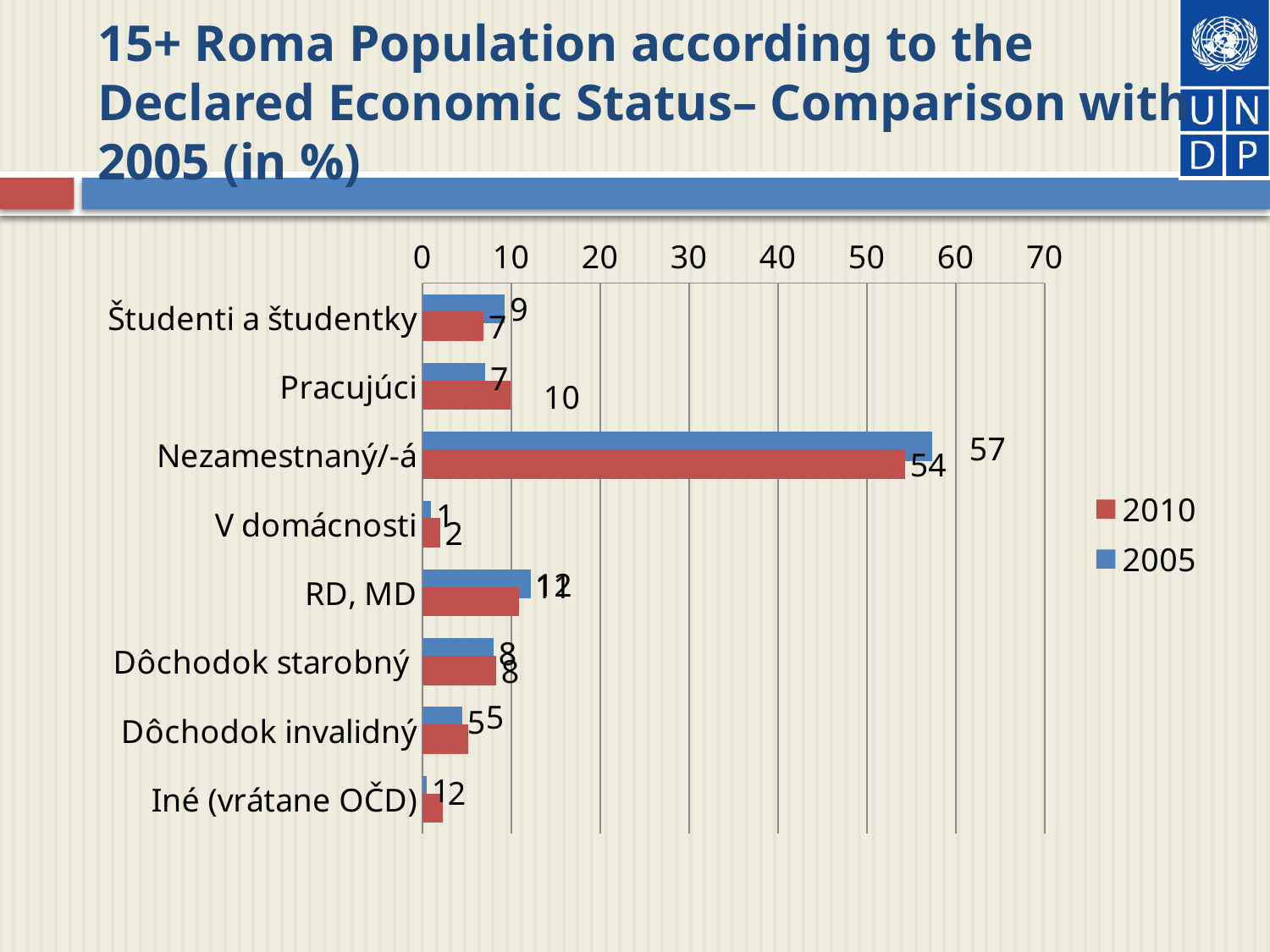
What is the 2010 value for Pracujúci? 10 What is the 2010 value for Nezamestnaný/-á? 54 What is the difference between the 2005 and 2010 values for Nezamestnaný/-á? 3 What is the 2005 value for Nezamestnaný/-á? 57 For Pracujúci, which year has the larger value, 2005 or 2010? 2010 How many series does the legend list? 2 Which category has the highest 2010 value? Nezamestnaný/-á Is the 2005 value for Nezamestnaný/-á greater or less than 50? greater What kind of chart is shown on the slide? bar chart Which colour represents the 2010 series in the legend? red What is the 2005 value for Študenti a študentky? 9 How many economic status categories are shown on the chart? 8